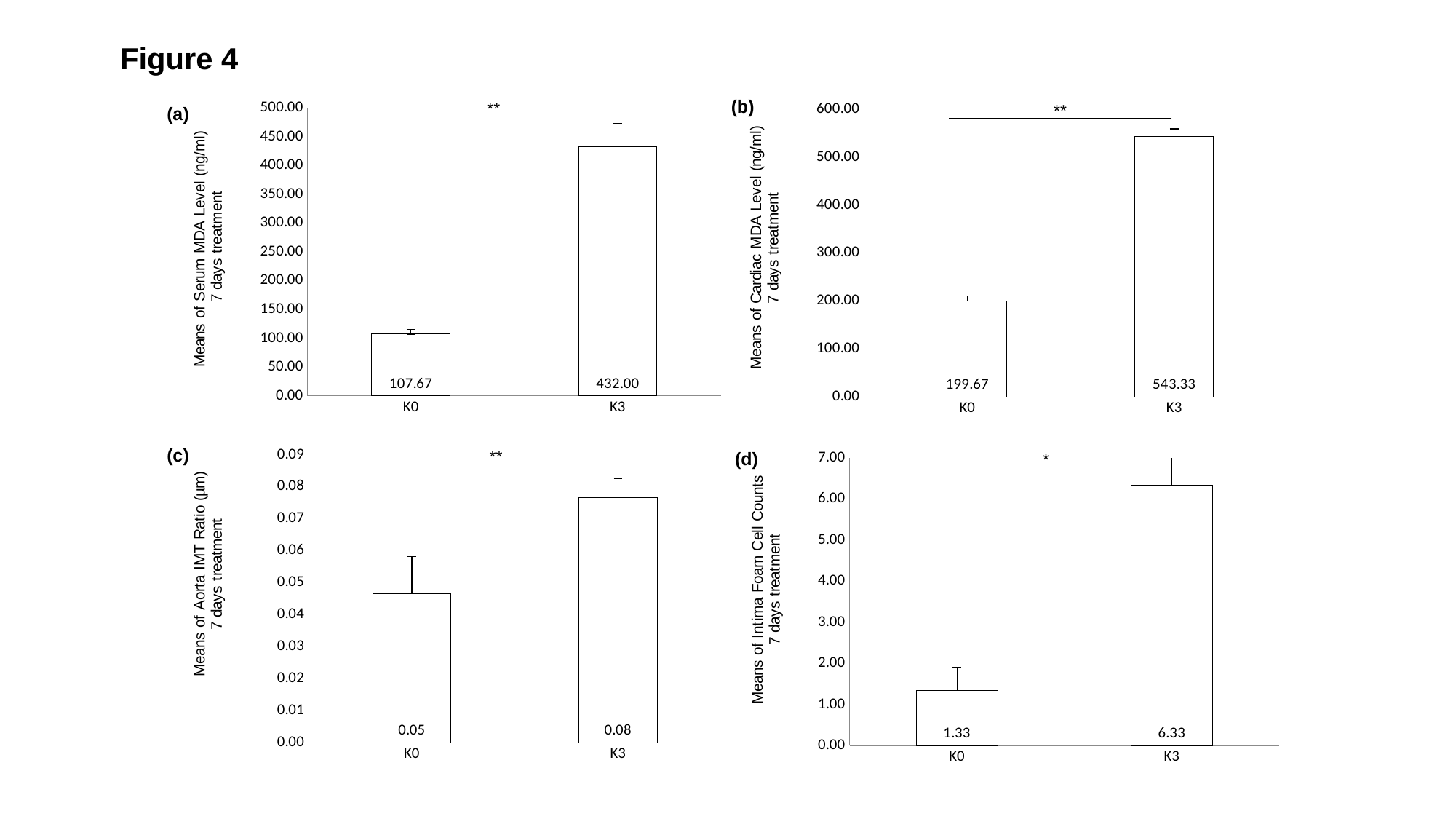
In chart (a), which category has the highest value? K3 In chart (c), what is the value for K3? 0.08 In chart (d), which category has the lowest value? K0 In chart (d), what is the difference between the values for K3 and K0? 5.00 What kind of chart is chart (a)? bar chart In chart (c), which is larger, the value for K0 or the value for K3? K3 In chart (a), what is the value for K3? 432.00 In chart (d), what is the value for K0? 1.33 In chart (b), what is the difference between the values for K3 and K0? 343.66 In chart (b), what is the value for K0? 199.67 What is the y-axis label of chart (c)? Means of Aorta IMT Ratio (µm) 7 days treatment How many categories are shown in chart (b)? 2